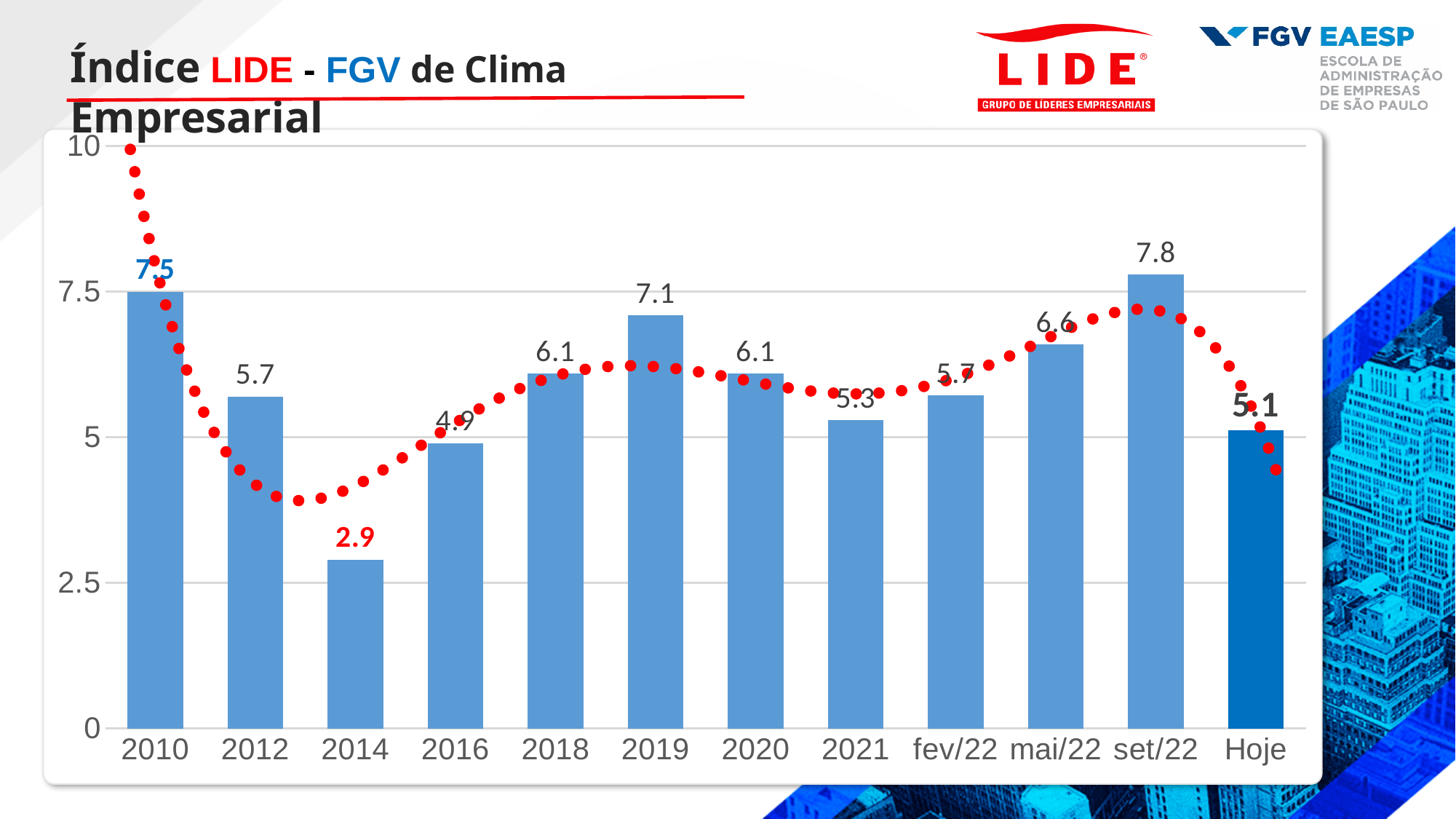
How many bars are plotted in the chart? 12 What is the difference between the values for set/22 and Hoje? 2.7 Which category has the highest bar? set/22 What is the value of the bar for 2014? 2.9 What is the value of the bar for 2019? 7.1 What kind of chart is shown on the slide? bar chart What is the value of the bar labelled Hoje? 5.1 Which is larger, the value for mai/22 or the value for fev/22? mai/22 Do the bar values rise or fall from 2014 to 2019? rise What is the value of the bar for set/22? 7.8 What is the difference between the values for 2010 and 2012? 1.8 Which category has the lowest bar? 2014